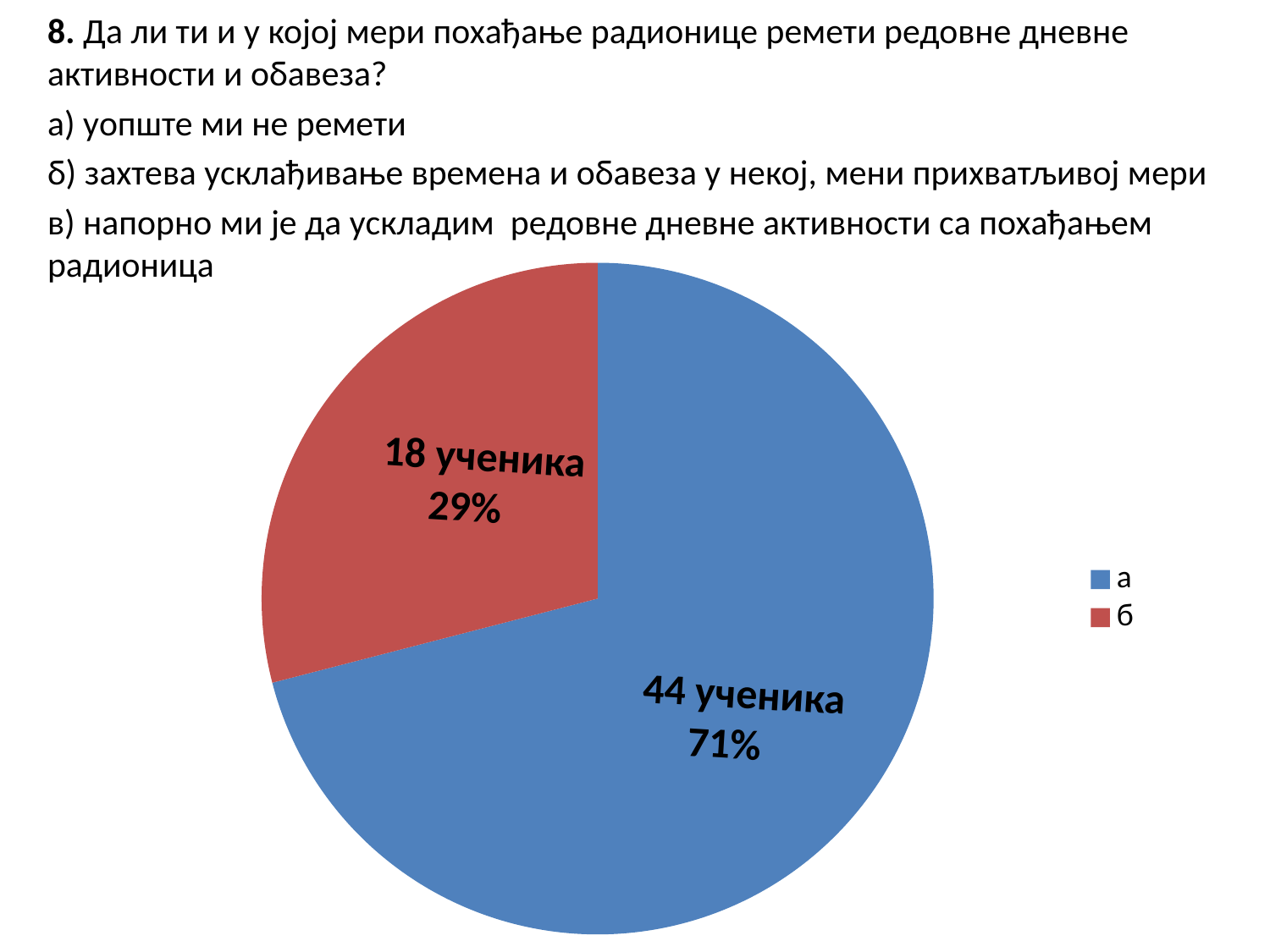
What share of the pie does answer а take? 71% How many slices does the pie chart have? 2 What kind of chart is shown on the slide? pie chart Which answer has the largest slice of the pie? а How many entries does the legend list? 2 Which answer was chosen by more students, а or б? а How many more students chose answer а than answer б? 26 What share of the pie does answer б take? 29% What colour is the slice for answer б? red Which answer has the smallest slice of the pie? б How many students chose answer б? 18 ученика How many students chose answer а? 44 ученика